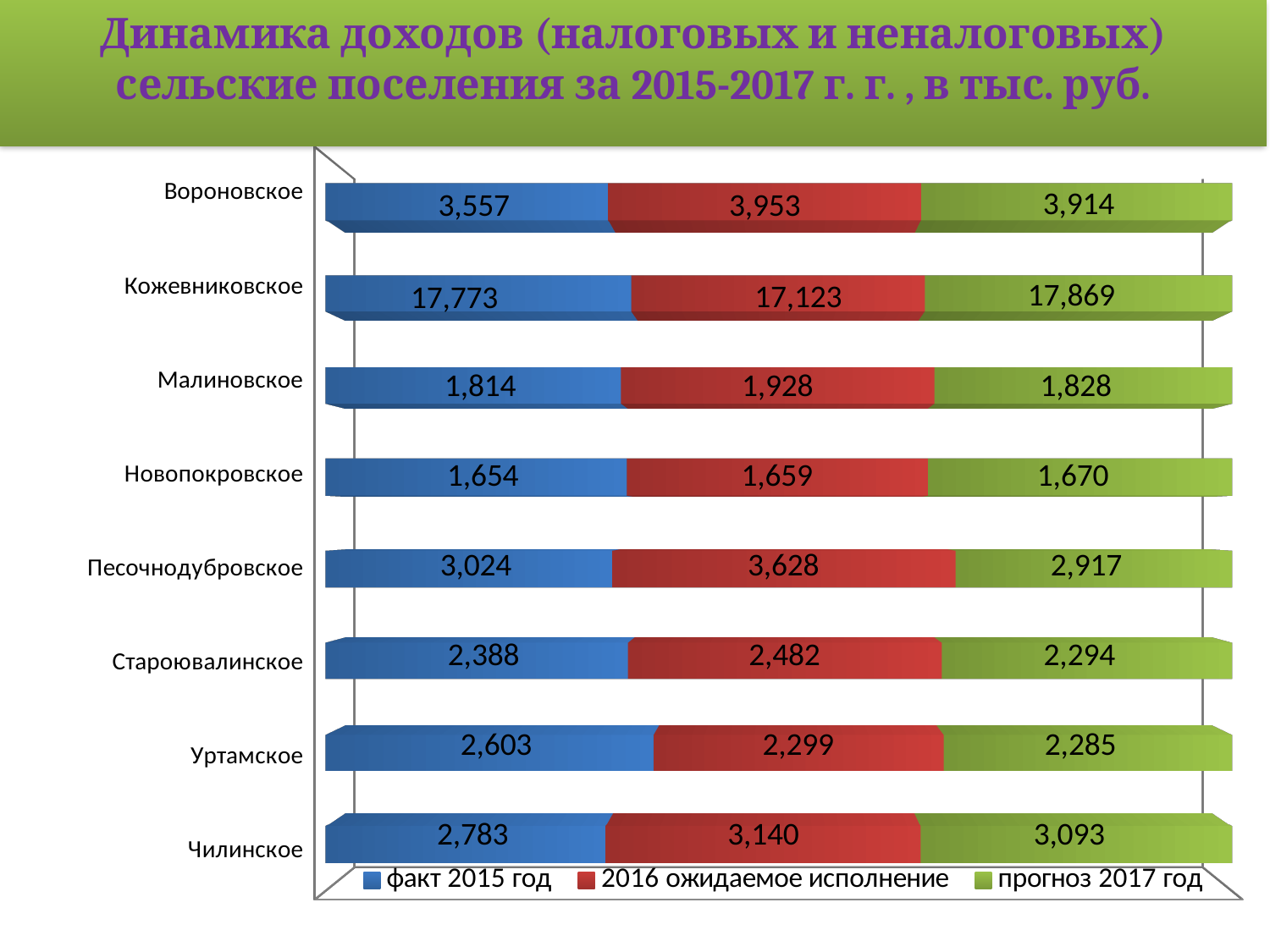
What is the value for Чилинское in the прогноз 2017 год series? 3,093 What is the value for Уртамское in the факт 2015 год series? 2,603 Which settlement has the lowest value in the прогноз 2017 год series? Новопокровское What is the difference between the 2016 ожидаемое исполнение and факт 2015 год values for Вороновское? 396 What is the value for Кожевниковское in the факт 2015 год series? 17,773 What kind of chart is shown on the slide? Bar chart Which settlement has the highest value in the факт 2015 год series? Кожевниковское What is the value for Песочнодубровское in the 2016 ожидаемое исполнение series? 3,628 What is the difference between the прогноз 2017 год and 2016 ожидаемое исполнение values for Кожевниковское? 746 How many series does the legend list? 3 For Песочнодубровское, which is larger: the 2016 ожидаемое исполнение value or the прогноз 2017 год value? 2016 ожидаемое исполнение How many settlements are shown on the chart? 8